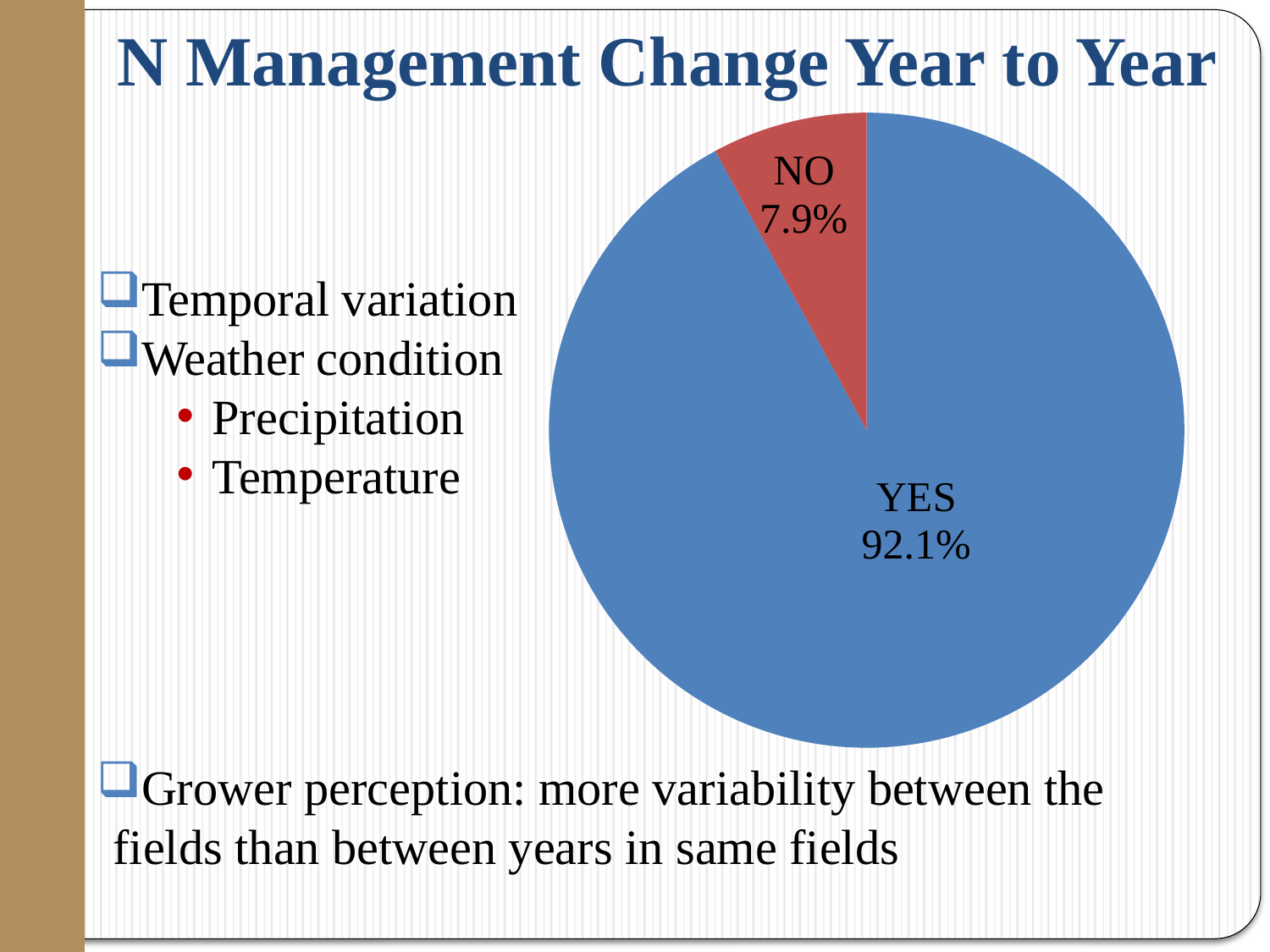
Which slice of the pie is the smallest? NO Which slice of the pie is the largest? YES Which is larger, the YES slice or the NO slice? YES What percentage of the pie is labelled YES? 92.1% What share of the pie does the NO slice represent? 7.9% What colour is the YES slice of the pie? blue What percentage of the pie is labelled NO? 7.9% What kind of chart is shown on the slide? pie chart What colour is the NO slice of the pie? red How many slices does the pie chart have? 2 What is the difference in percentage points between the YES and NO slices? 84.2